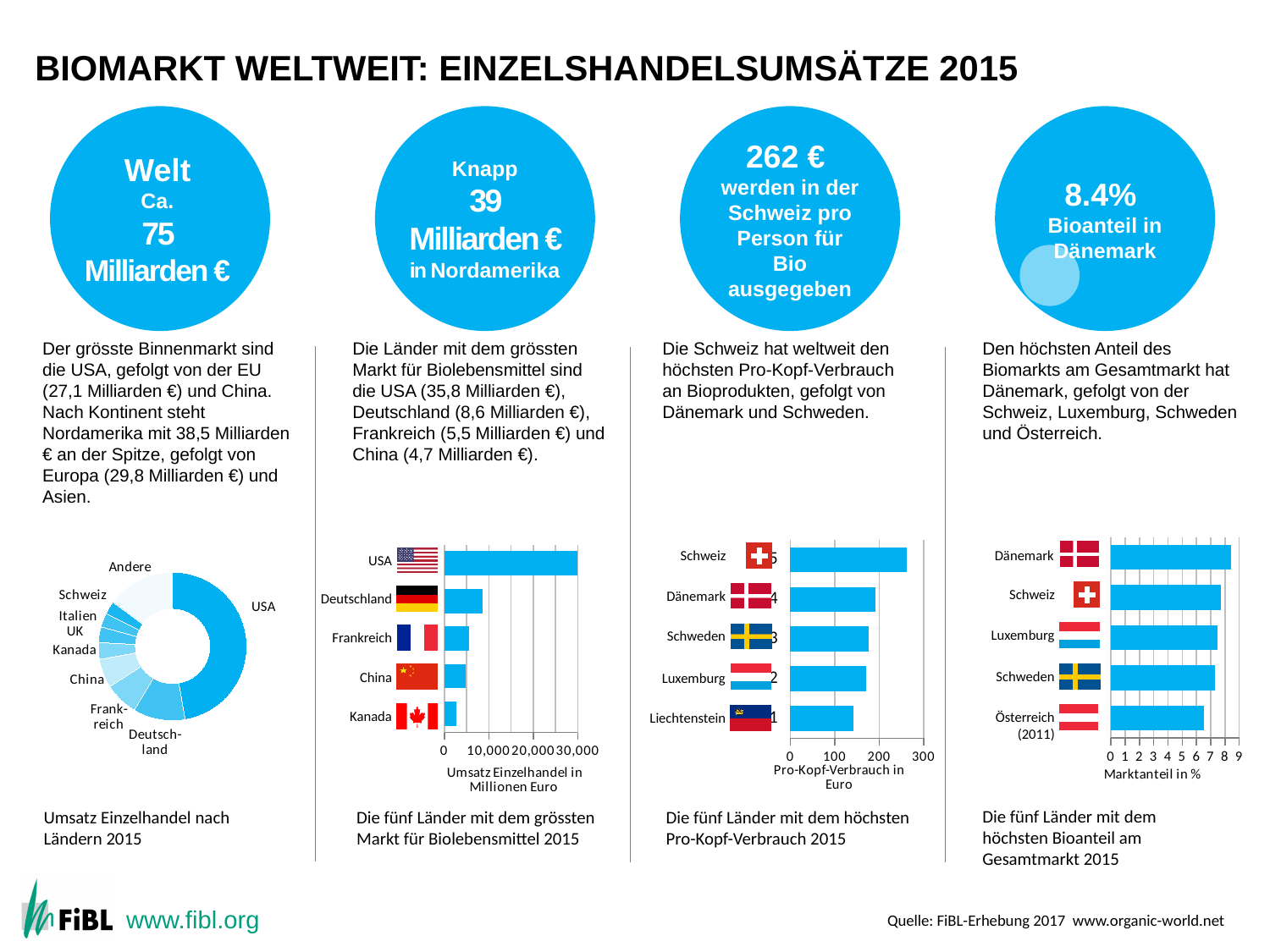
In the chart titled 'Die fünf Länder mit dem grössten Markt für Biolebensmittel 2015', which country has the highest value? USA In the chart titled 'Die fünf Länder mit dem höchsten Pro-Kopf-Verbrauch 2015', is the value for Schweiz greater or less than 200? greater In the chart titled 'Die fünf Länder mit dem grössten Markt für Biolebensmittel 2015', which country has the lowest value? Kanada In the chart titled 'Die fünf Länder mit dem höchsten Bioanteil am Gesamtmarkt 2015', which country has the lowest value? Österreich (2011) In the chart titled 'Die fünf Länder mit dem höchsten Pro-Kopf-Verbrauch 2015', is the value for Liechtenstein greater or less than 100? greater In the chart titled 'Die fünf Länder mit dem höchsten Pro-Kopf-Verbrauch 2015', which country has the highest value? Schweiz In the chart titled 'Die fünf Länder mit dem grössten Markt für Biolebensmittel 2015', is the value for USA greater or less than 30,000? greater What kind of chart is 'Umsatz Einzelhandel nach Ländern 2015'? Donut chart In the chart titled 'Die fünf Länder mit dem höchsten Bioanteil am Gesamtmarkt 2015', which country has the highest value? Dänemark